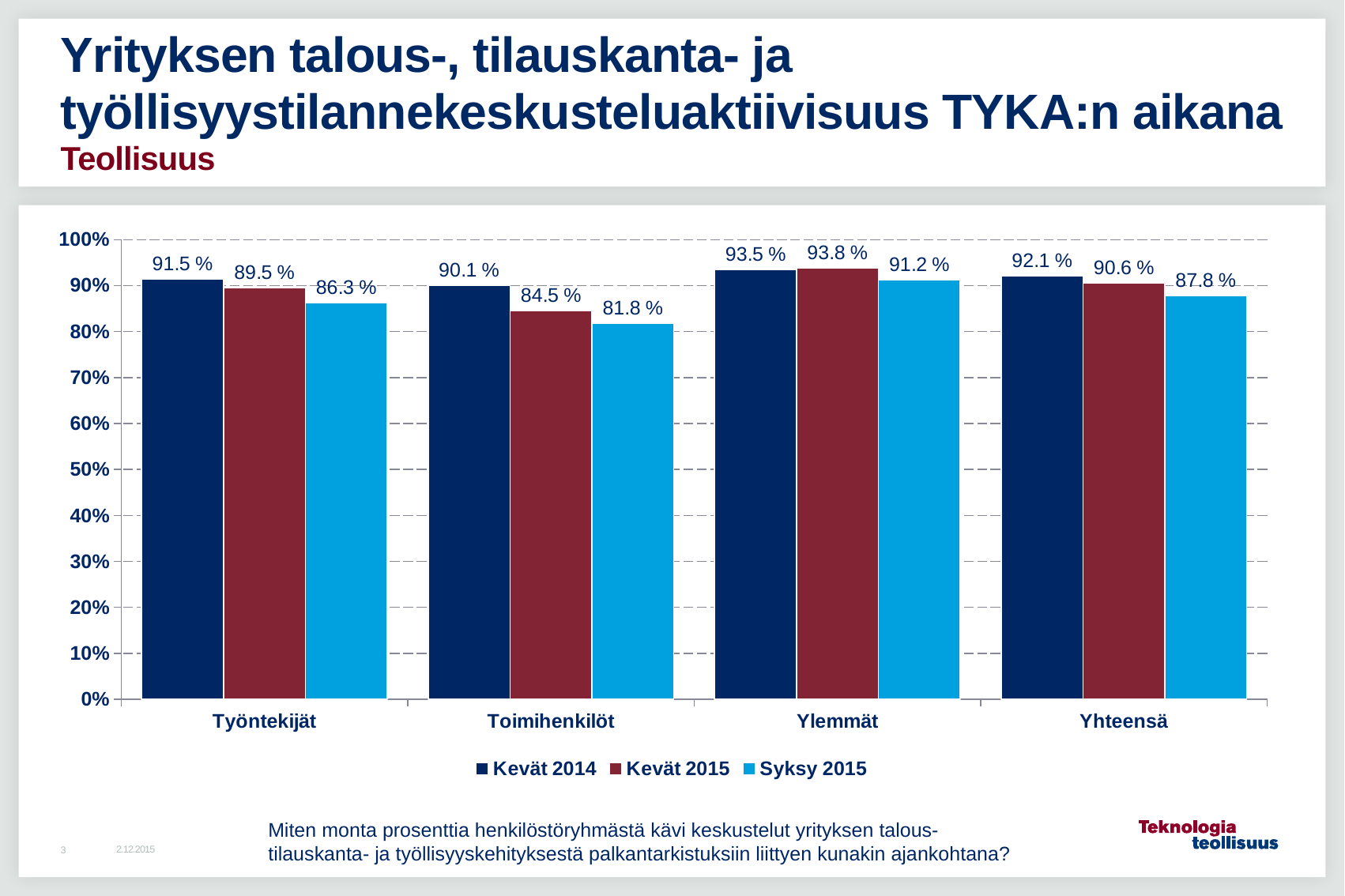
Which category has the lowest value in the Syksy 2015 series? Toimihenkilöt Which is larger for Työntekijät: the Kevät 2015 value or the Syksy 2015 value? Kevät 2015 What is the value for Toimihenkilöt in the Syksy 2015 series? 81.8 % What is the value for Yhteensä in the Syksy 2015 series? 87.8 % What kind of chart is shown on the slide? Bar chart What is the value for Työntekijät in the Kevät 2014 series? 91.5 % Which category has the highest value in the Kevät 2014 series? Ylemmät What is the value for Ylemmät in the Kevät 2015 series? 93.8 % How many categories are shown on the x axis? 4 What is the difference between the Kevät 2014 and Syksy 2015 values for Toimihenkilöt? 8.3 % Which series is shown in light blue in the legend? Syksy 2015 How many series does the legend list? 3